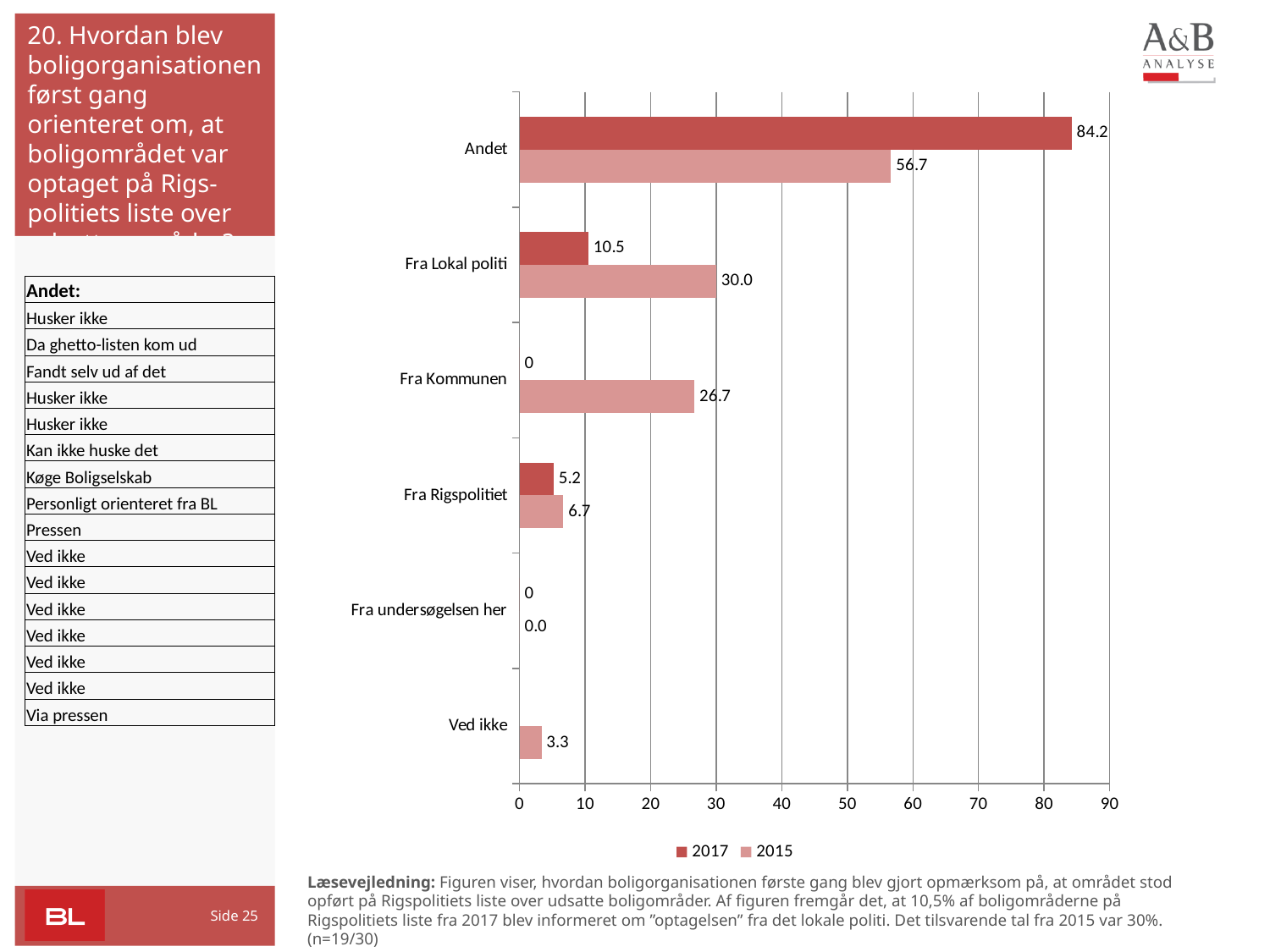
How many categories are shown on the chart? 6 Which is larger for Fra Rigspolitiet, the 2017 value or the 2015 value? 2015 What is the 2015 value for Fra Lokal politi? 30.0 What is the difference between the 2017 and 2015 values for Andet? 27.5 What is the 2015 value for Fra Kommunen? 26.7 What is the 2017 value for Fra Rigspolitiet? 5.2 What is the 2017 value for Andet? 84.2 What is the 2015 value for Ved ikke? 3.3 How many series does the legend list? 2 Which category has the highest 2017 value? Andet What is the difference between the 2015 and 2017 values for Fra Lokal politi? 19.5 What kind of chart is shown on the slide? Bar chart